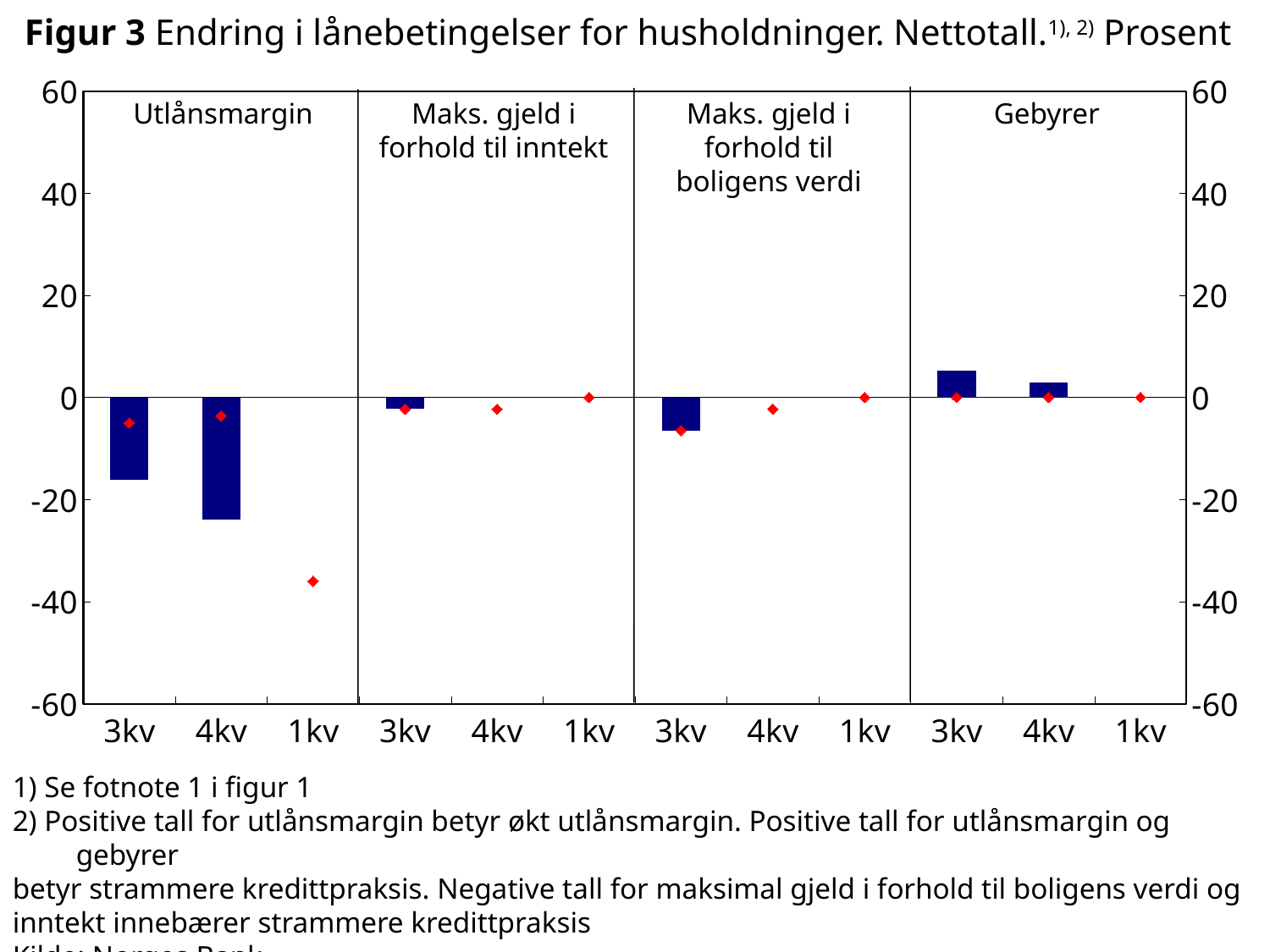
In the Gebyrer panel, which bar is higher, 3kv or 4kv? 3kv What kind of chart is shown in Figur 3? combination bar and marker (line) chart In the Utlånsmargin panel, which bar is lower, 3kv or 4kv? 4kv How many panels (loan condition categories) does the chart have? 4 Is the bar for 3kv in the Gebyrer panel greater or less than 0? greater Is the bar for 4kv in the Utlånsmargin panel greater or less than -20? less How many quarters are shown on the x axis within each panel? 3 What is the maximum value shown on the y axis? 60 Which panel contains the highest bar in the chart? Gebyrer Is the bar for 3kv in the Utlånsmargin panel greater or less than -20? greater Which panel contains the lowest bar in the chart? Utlånsmargin